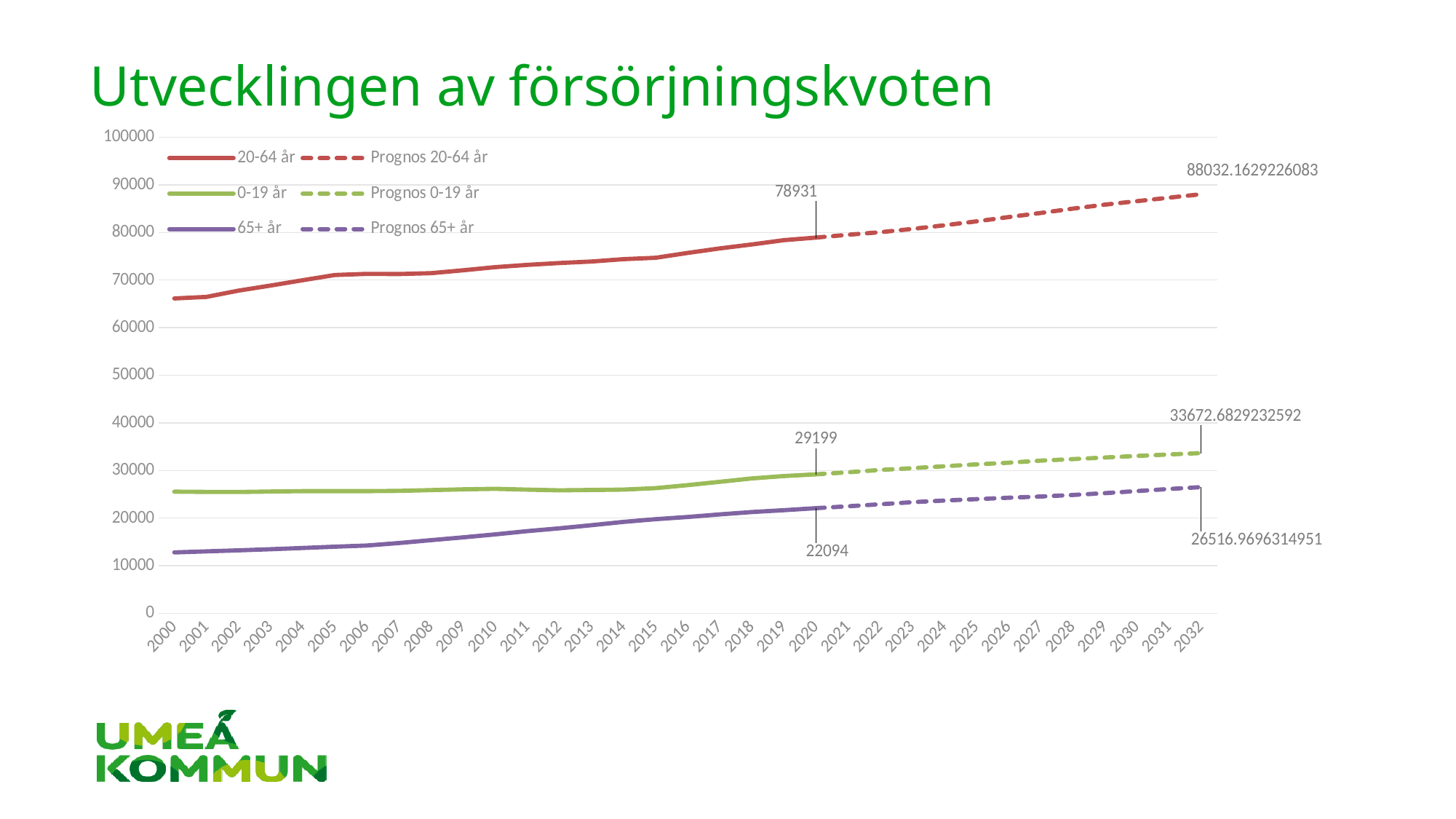
What is the value for Prognos 0-19 år in 2032? 33672.6829232592 What kind of chart is shown on the slide? line chart What is the value for Prognos 65+ år in 2032? 26516.9696314951 What is the value for 20-64 år in 2020? 78931 What is the difference between the 2020 values for 20-64 år and 0-19 år? 49732 Is the value for 20-64 år in 2000 greater or less than 70000? less What is the value for 0-19 år in 2020? 29199 What is the value for Prognos 20-64 år in 2032? 88032.1629226083 Which is larger in 2020, the value for 0-19 år or the value for 65+ år? 0-19 år What is the value for 65+ år in 2020? 22094 Does the 65+ år line rise or fall from 2000 to 2020? rise How many series does the legend list? 6